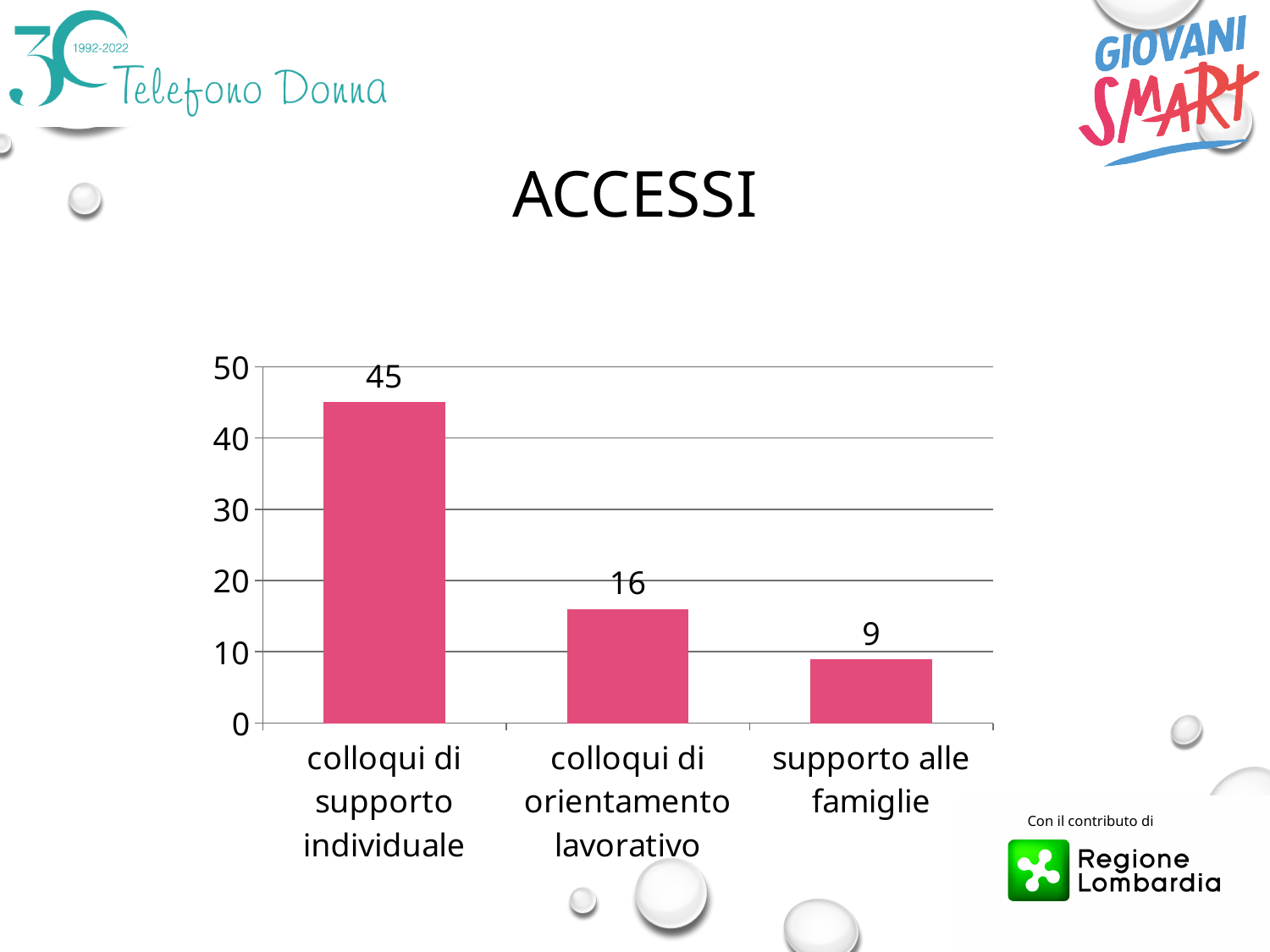
What is the value for supporto alle famiglie? 9 What is the title of the chart? ACCESSI What is the value for colloqui di supporto individuale? 45 How many categories are shown in the chart? 3 Which category has the lowest value? supporto alle famiglie Is the value for supporto alle famiglie greater or less than 10? less What is the value for colloqui di orientamento lavorativo? 16 Which category has the highest value? colloqui di supporto individuale What kind of chart is shown on the slide? bar chart What is the difference between colloqui di orientamento lavorativo and supporto alle famiglie? 7 Which is larger, colloqui di orientamento lavorativo or supporto alle famiglie? colloqui di orientamento lavorativo What is the difference between colloqui di supporto individuale and colloqui di orientamento lavorativo? 29